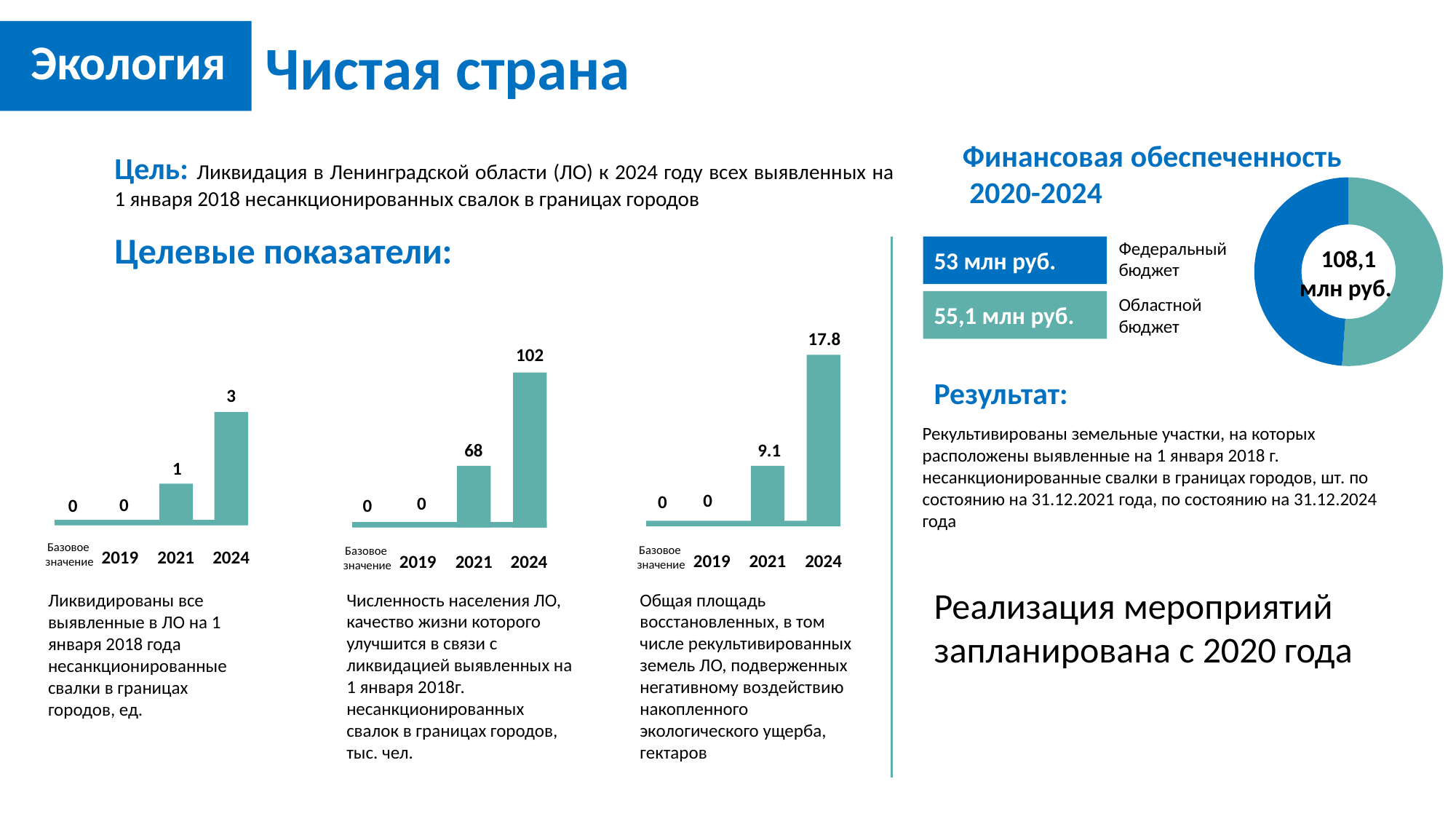
In the rightmost bar chart (restored land area, hectares), what is the value for 2024? 17.8 In the donut chart under 'Финансовая обеспеченность 2020-2024', what is the value for the regional budget (Областной бюджет)? 55,1 млн руб. In the leftmost bar chart (liquidated unauthorized landfills, units), what is the value for 2024? 3 In the leftmost bar chart, what is the value for 2021? 1 In the rightmost bar chart, what is the value for 2021? 9.1 In the middle bar chart, what is the value for 2024? 102 In the middle bar chart, do the values rise or fall from left to right along the x axis? rise How many categories are shown on the x axis of the leftmost bar chart? 4 In the rightmost bar chart, which category has the highest value? 2024 In the rightmost bar chart, what is the value for 2019? 0 In the middle bar chart (population with improved quality of life, thousand people), what is the value for 2021? 68 In the middle bar chart, what is the difference between the 2024 and 2021 values? 34